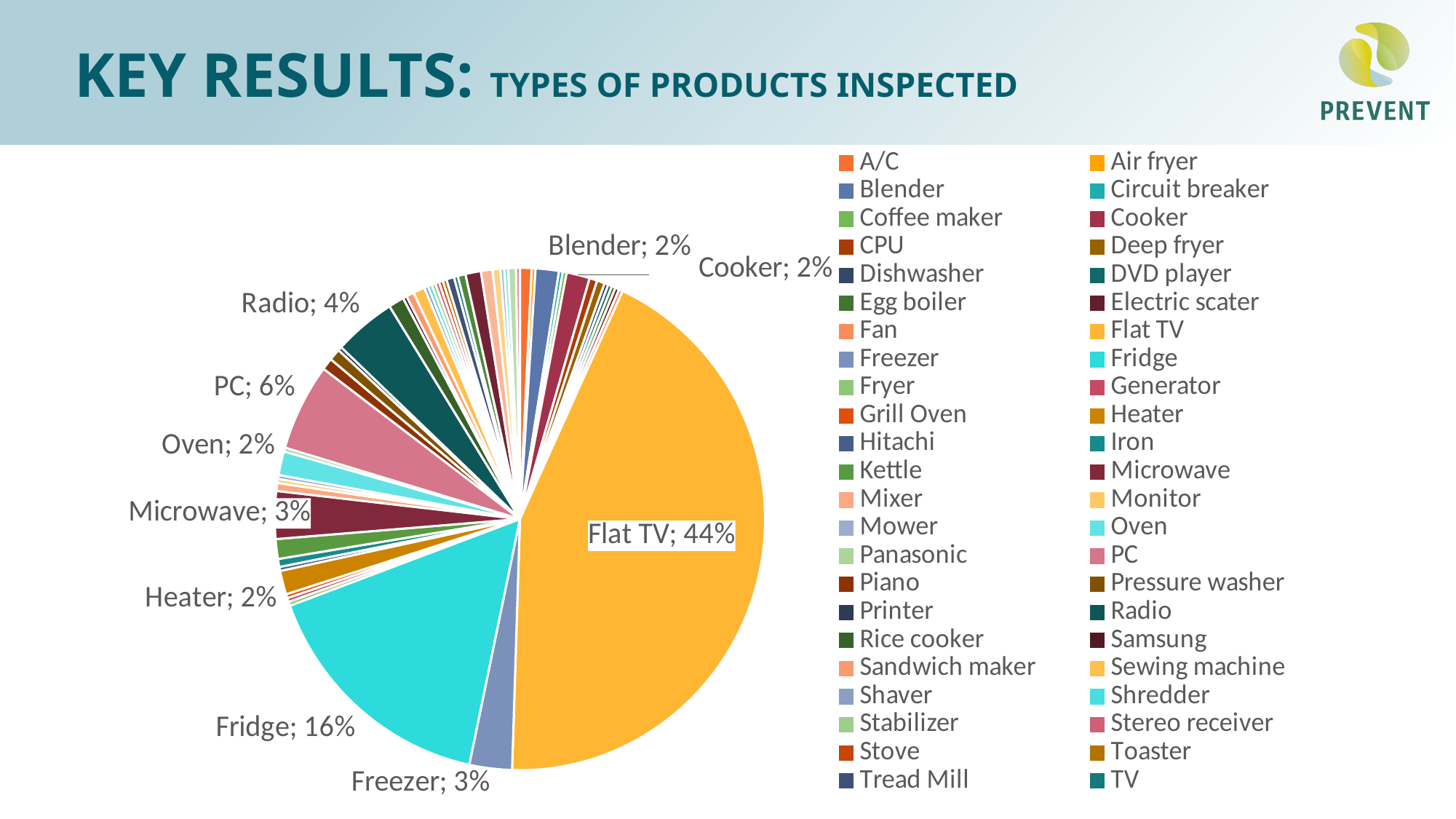
Which product type has the largest slice of the pie? Flat TV Which has a larger share, PC or Radio? PC What percentage is shown for PC? 6% What percentage is shown for Freezer? 3% How many percentage points larger is the Flat TV share than the Fridge share? 28 What share of products inspected were Flat TVs? 44% Which has a larger share, Fridge or Microwave? Fridge What percentage is shown for Radio? 4% What percentage is shown for Fridge? 16% What is the title of the slide containing the chart? KEY RESULTS: TYPES OF PRODUCTS INSPECTED How many product types are listed in the legend? 46 What kind of chart is shown on the slide? pie chart